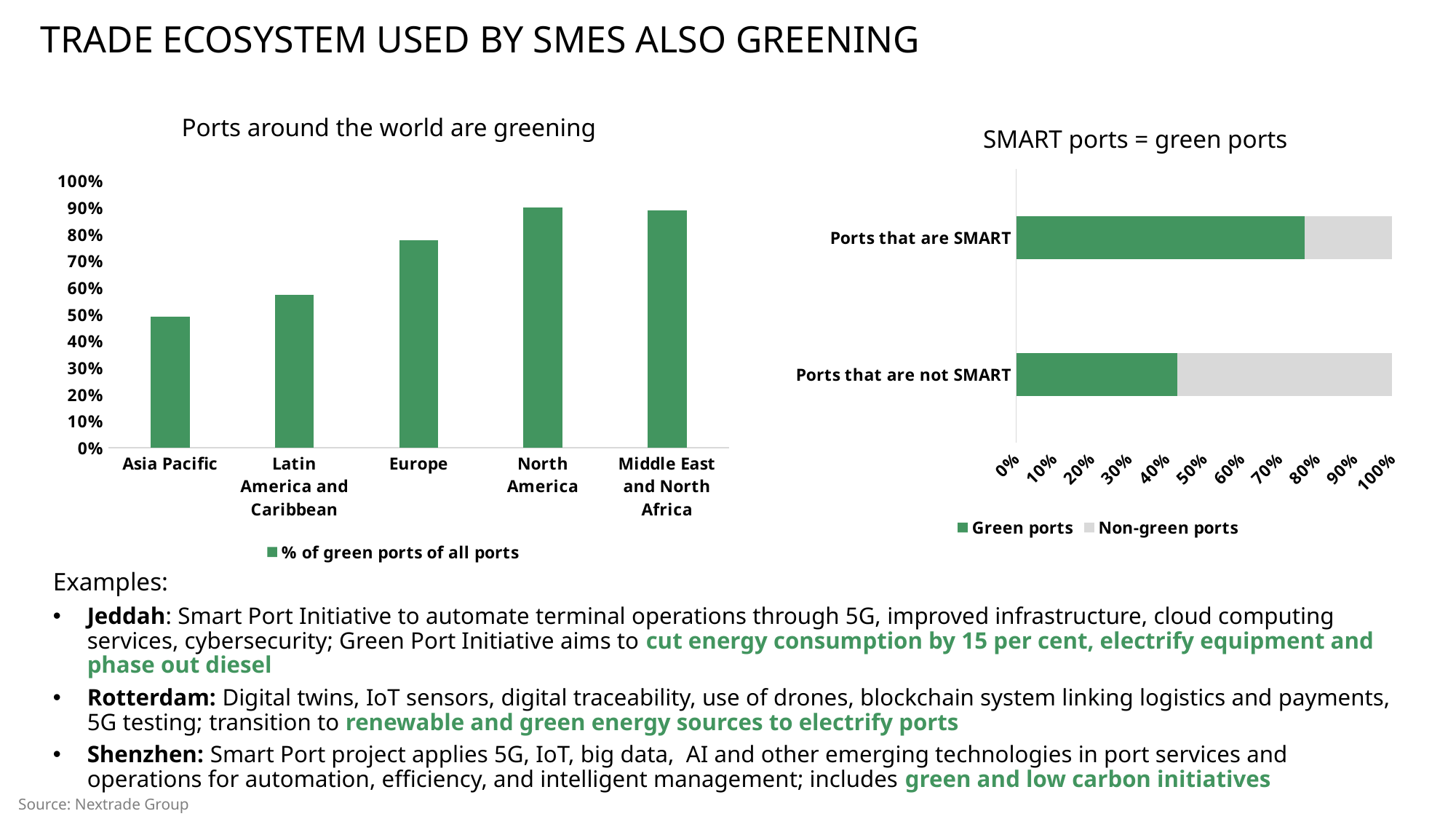
In the chart titled 'SMART ports = green ports', is the green ports share for Ports that are SMART greater or less than 70%? greater In the chart titled 'Ports around the world are greening', what kind of chart is shown? bar chart In the chart titled 'SMART ports = green ports', is the green ports share for Ports that are not SMART greater or less than 50%? less In the chart titled 'Ports around the world are greening', is the value for Latin America and Caribbean greater or less than 60%? less In the chart titled 'Ports around the world are greening', which region has the lowest share of green ports? Asia Pacific In the chart titled 'Ports around the world are greening', which is larger, the value for Europe or the value for Latin America and Caribbean? Europe In the chart titled 'Ports around the world are greening', how many regions are plotted? 5 In the chart titled 'SMART ports = green ports', which category has the larger share of green ports, Ports that are SMART or Ports that are not SMART? Ports that are SMART In the chart titled 'Ports around the world are greening', what is the legend entry for the plotted series? % of green ports of all ports In the chart titled 'SMART ports = green ports', how many series does the legend list? 2